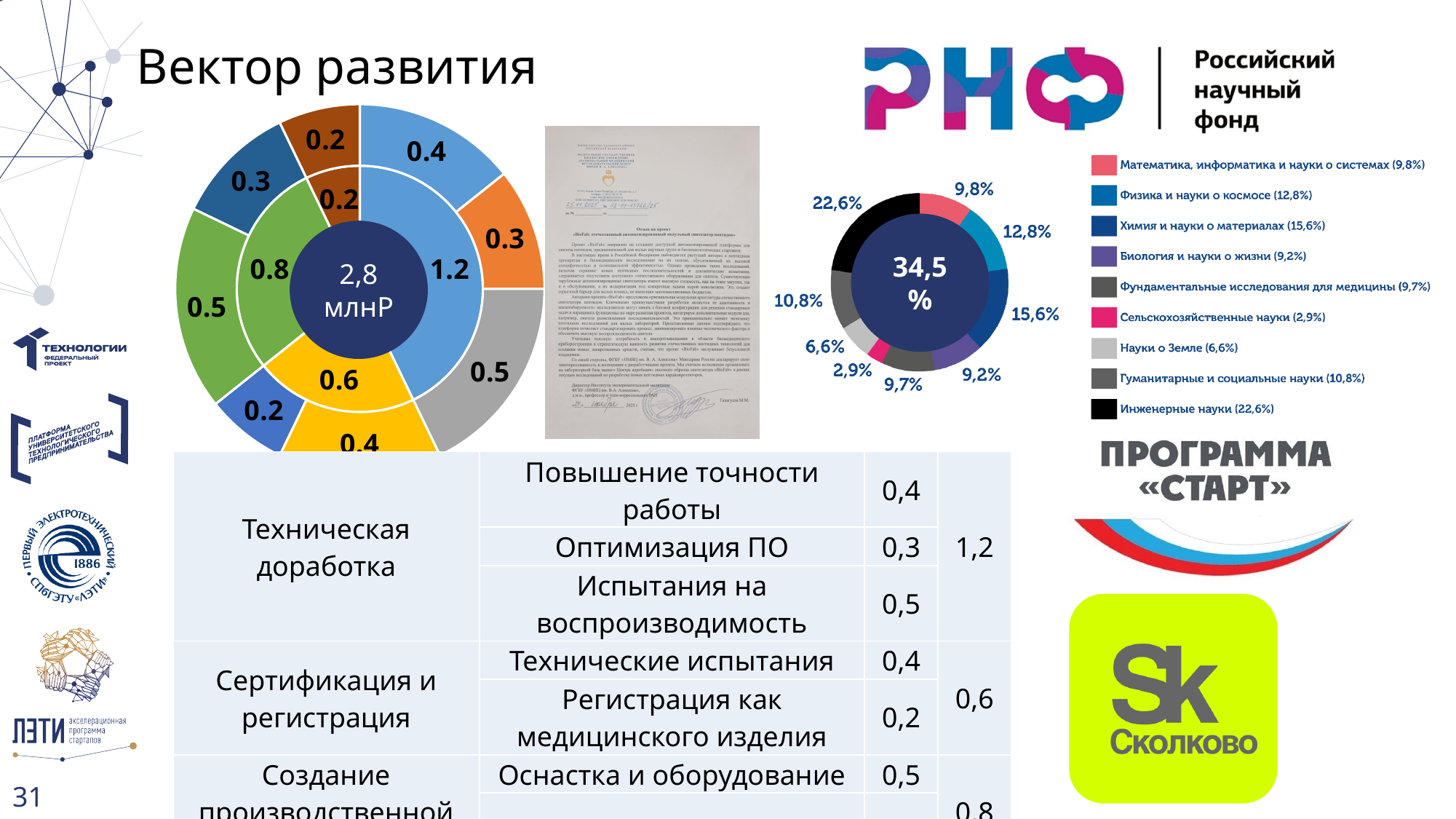
What kind of chart is the chart on the right of the slide with the legend listing scientific fields? doughnut chart What value is printed in the centre of the doughnut chart on the right? 34,5 % In the sunburst chart on the left, how many segments does the inner ring have? 4 What value is printed in the centre of the sunburst chart on the left of the slide? 2,8 млнР In the doughnut chart on the right, which category has the smallest share? Сельскохозяйственные науки In the doughnut chart on the right, how many categories does the legend list? 9 In the doughnut chart on the right, what share is shown for Инженерные науки? 22,6% In the doughnut chart on the right, what is the difference between the shares of Химия и науки о материалах and Биология и науки о жизни? 6,4% In the doughnut chart on the right, which category has the largest share? Инженерные науки In the sunburst chart on the left, what is the largest value shown on the inner ring? 1.2 In the doughnut chart on the right, which is larger: Физика и науки о космосе or Гуманитарные и социальные науки? Физика и науки о космосе In the doughnut chart on the right, what share is shown for Химия и науки о материалах? 15,6%